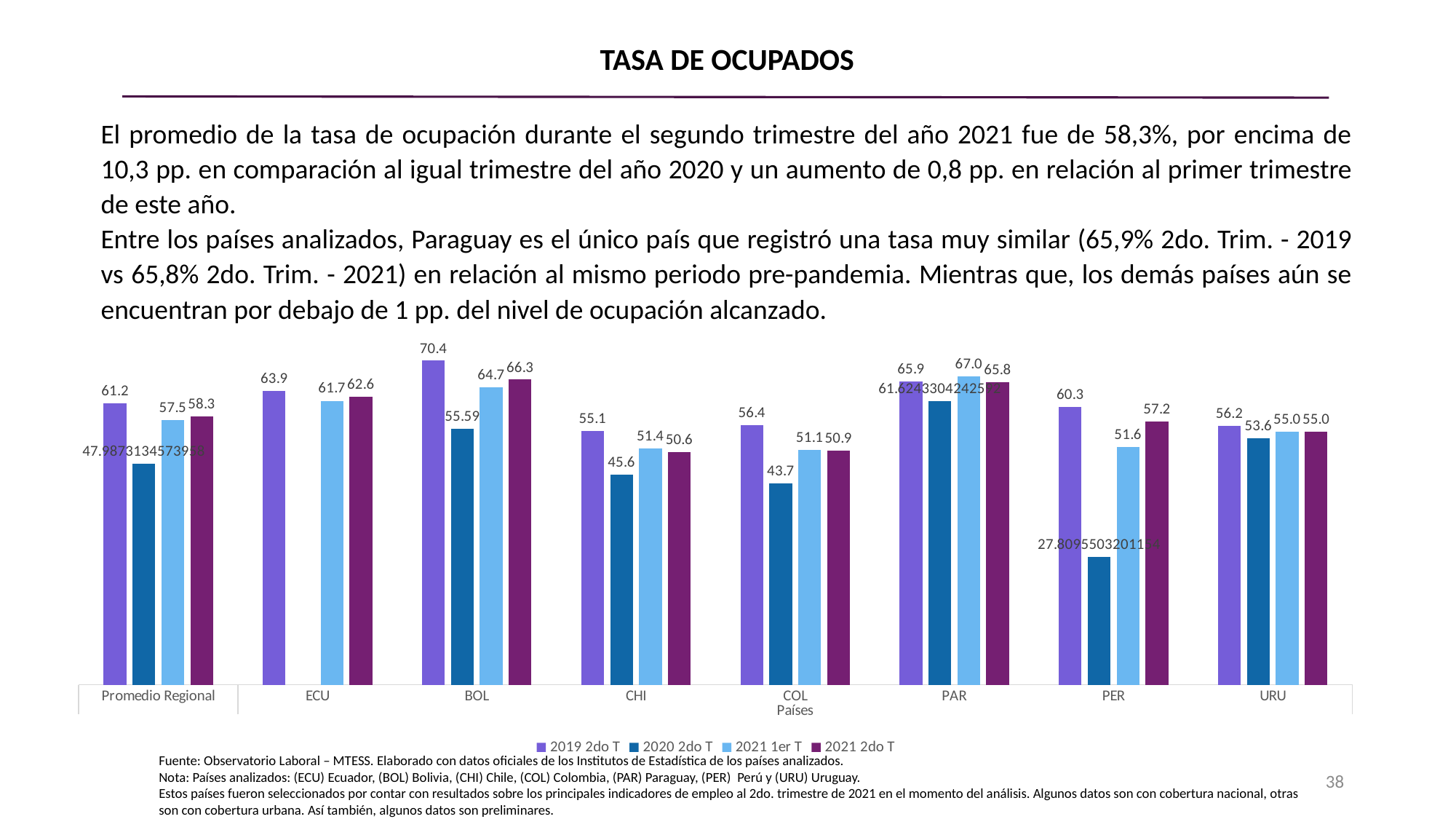
What is the title of the chart on the slide? TASA DE OCUPADOS What is the value for BOL in the 2019 2do T series? 70.4 Which is larger for COL: the 2021 1er T value or the 2021 2do T value? 2021 1er T Which category has the highest value in the 2019 2do T series? BOL What is the value for Promedio Regional in the 2021 2do T series? 58.3 What is the difference between the 2019 2do T and 2021 2do T values for CHI? 4.5 Which category has the lowest value in the 2020 2do T series? PER What kind of chart is shown on the slide? bar chart What is the value for PER in the 2021 2do T series? 57.2 How many categories are shown on the x axis of the chart? 8 How many series does the legend list? 4 What is the value for PAR in the 2021 1er T series? 67.0